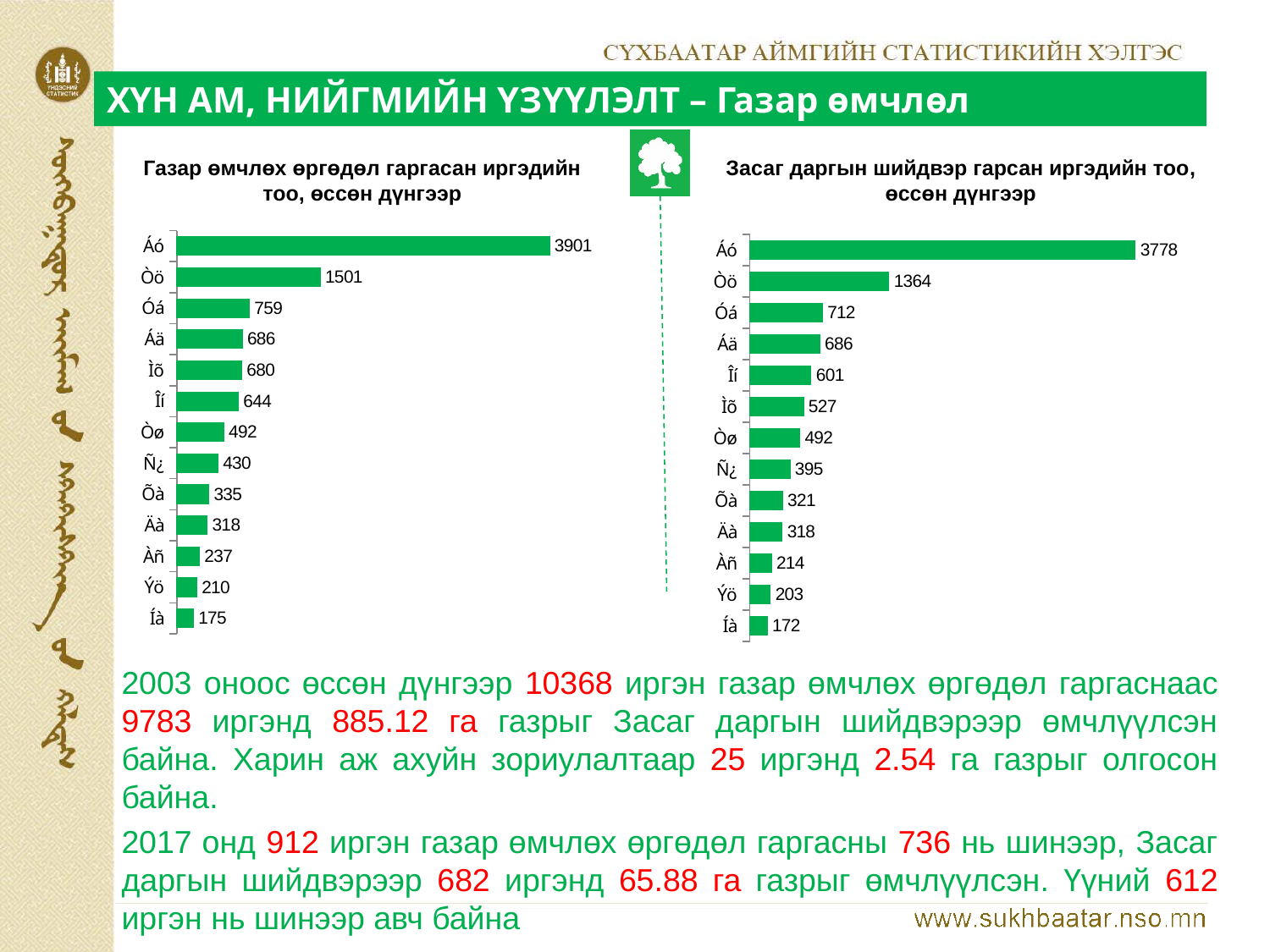
In the right chart (Засаг даргын шийдвэр гарсан иргэдийн тоо, өссөн дүнгээр), what is the value of the longest bar? 3778 In the right chart (Засаг даргын шийдвэр гарсан иргэдийн тоо, өссөн дүнгээр), what is the difference between the top bar and the second bar from the top? 2414 In the left chart (Газар өмчлөх өргөдөл гаргасан иргэдийн тоо, өссөн дүнгээр), what is the value of the longest bar? 3901 In the right chart (Засаг даргын шийдвэр гарсан иргэдийн тоо, өссөн дүнгээр), what is the value of the shortest bar? 172 What type of chart is used for the left chart (Газар өмчлөх өргөдөл гаргасан иргэдийн тоо, өссөн дүнгээр)? Bar chart In the left chart (Газар өмчлөх өргөдөл гаргасан иргэдийн тоо, өссөн дүнгээр), what is the difference between the top bar and the second bar from the top? 2400 How many bars are plotted in the right chart (Засаг даргын шийдвэр гарсан иргэдийн тоо, өссөн дүнгээр)? 13 Which is larger: the top bar of the left chart or the top bar of the right chart? The top bar of the left chart (3901) In the right chart (Засаг даргын шийдвэр гарсан иргэдийн тоо, өссөн дүнгээр), what is the value of the third bar from the top? 712 In the left chart (Газар өмчлөх өргөдөл гаргасан иргэдийн тоо, өссөн дүнгээр), what is the value of the second bar from the top? 1501 In the left chart (Газар өмчлөх өргөдөл гаргасан иргэдийн тоо, өссөн дүнгээр), what is the value of the shortest bar? 175 How many bars are plotted in the left chart (Газар өмчлөх өргөдөл гаргасан иргэдийн тоо, өссөн дүнгээр)? 13